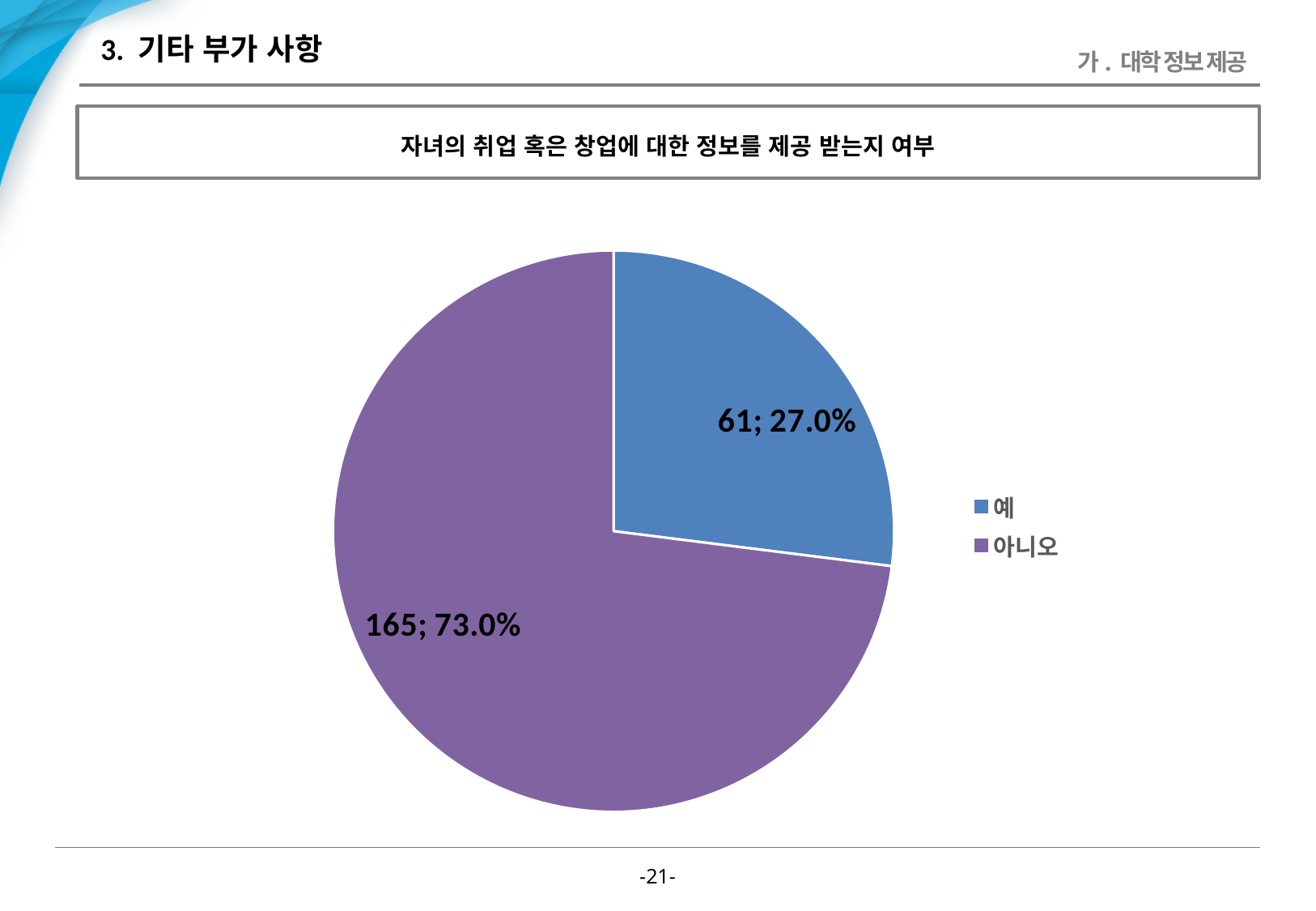
What colour is the 예 slice? blue What share of the pie does 아니오 represent? 73.0% What is the count for 아니오 in the pie chart? 165 What kind of chart is shown on the slide? pie chart What is the count for 예 in the pie chart? 61 How many slices does the pie chart have? 2 Which category has the largest slice? 아니오 What is the total of the two counts shown in the pie chart? 226 What share of the pie does 예 represent? 27.0% Which category has the smallest slice? 예 What is the difference between the counts for 아니오 and 예? 104 How many entries does the legend list? 2